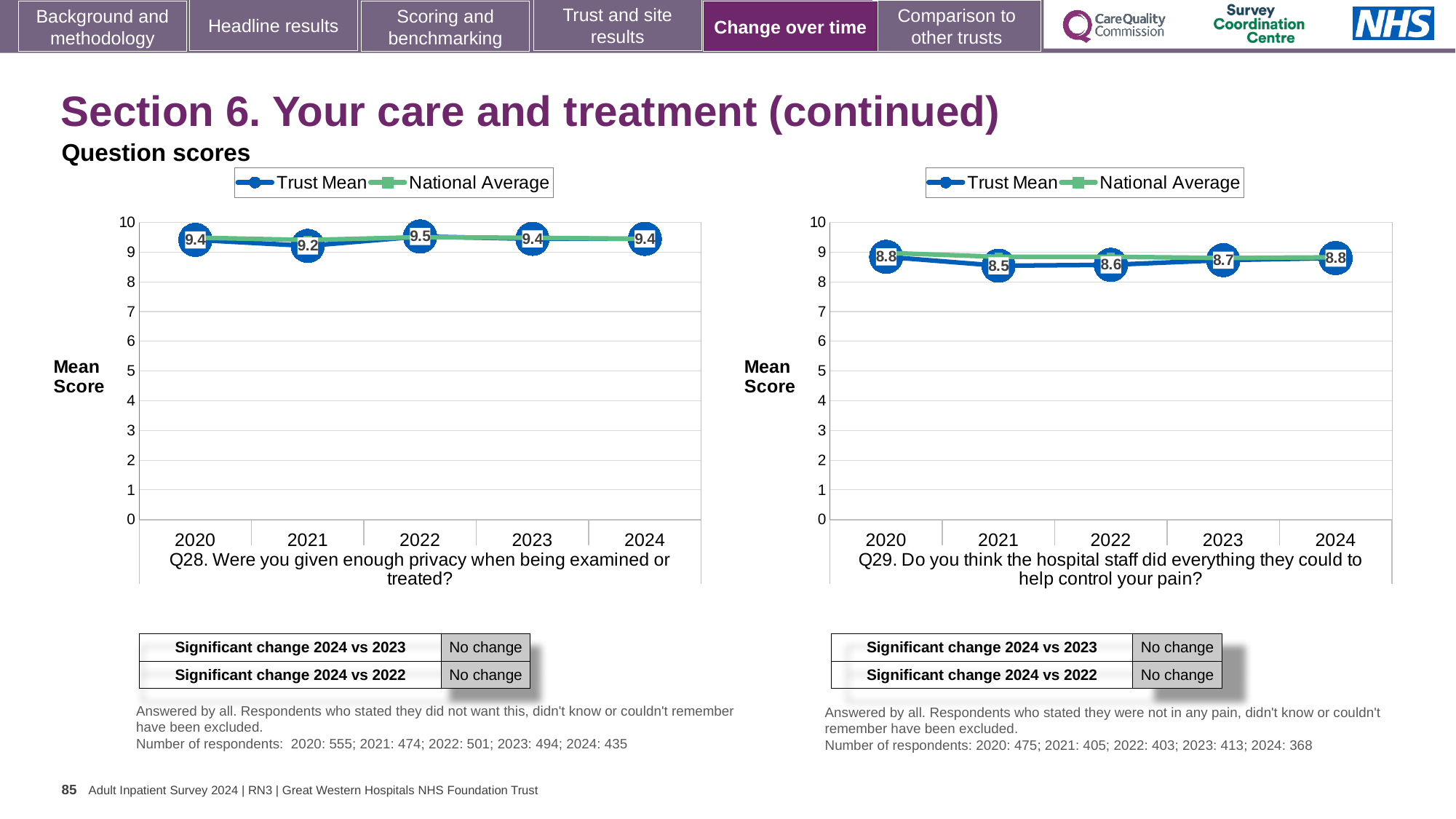
How many series does the legend of the Q28 chart on the left list? 2 In the Q29 chart on the right, what is the Trust Mean score for 2024? 8.8 In the Q29 chart on the right, which year has the lowest Trust Mean score? 2021 In the Q28 chart on the left, what is the Trust Mean score for 2022? 9.5 In the Q29 chart on the right, what is the Trust Mean score for 2021? 8.5 In the Q29 chart on the right, is the Trust Mean score higher in 2023 or in 2022? 2023 In the Q29 chart on the right, what is the difference between the Trust Mean scores for 2024 and 2021? 0.3 In the Q28 chart on the left, what is the difference between the Trust Mean scores for 2022 and 2021? 0.3 In the Q28 chart on the left, what is the Trust Mean score for 2021? 9.2 What kind of chart is the Q29 chart on the right? Line chart In the Q29 chart on the right, is the National Average value for 2021 greater or less than 8? greater In the Q28 chart on the left, which year has the highest Trust Mean score? 2022